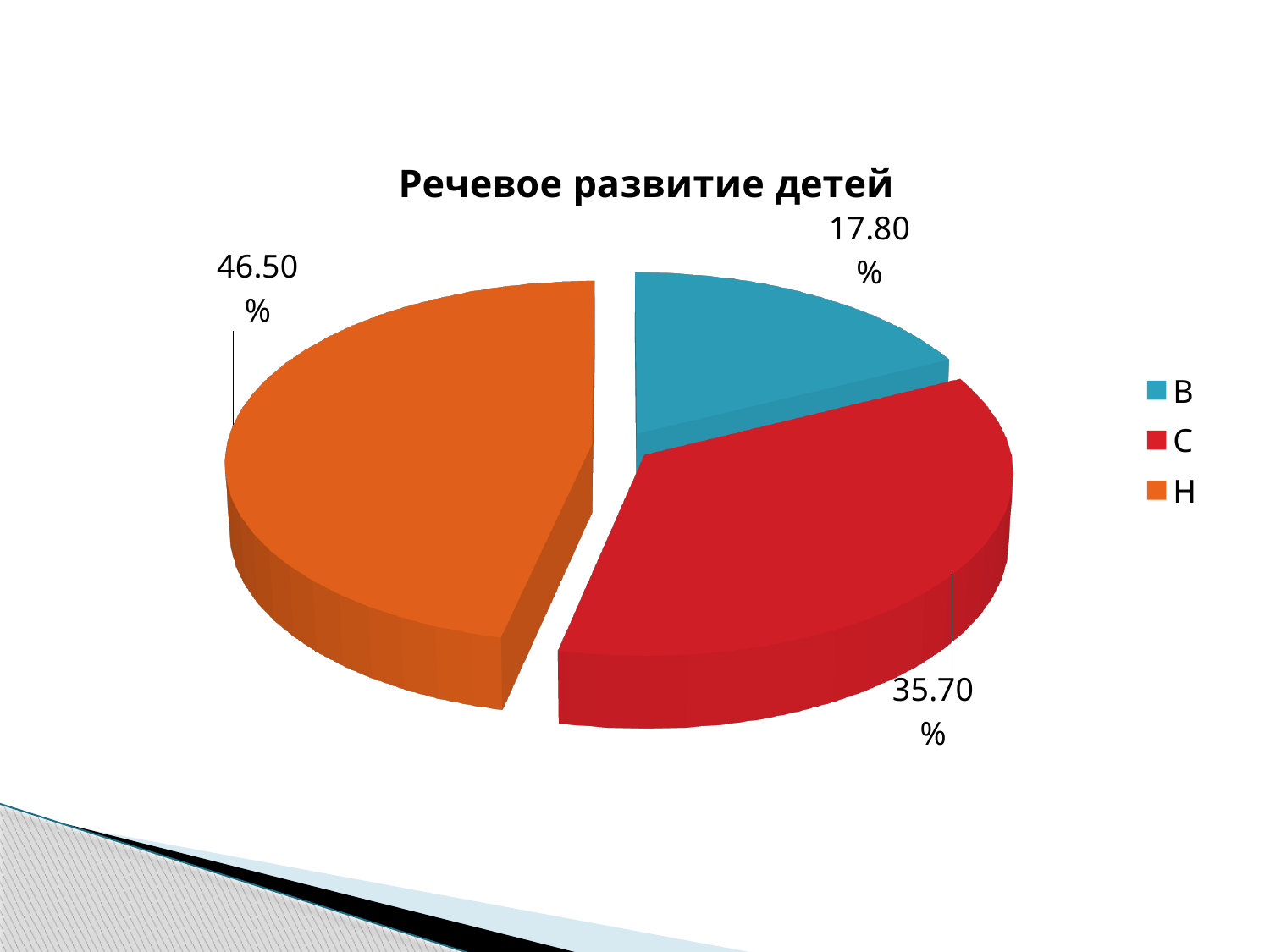
What is the title of the chart? Речевое развитие детей What is the difference between the values for С and В? 17.90% How many entries does the legend list? 3 Which category has the smallest share of the pie? В What is the value for category Н? 46.50% How many slices does the pie chart have? 3 Which category has the largest share of the pie? Н Which is larger, the value for С or the value for В? С What is the value for category В? 17.80% What kind of chart is shown on the slide? Pie chart What is the value for category С? 35.70% What is the difference between the values for Н and С? 10.80%